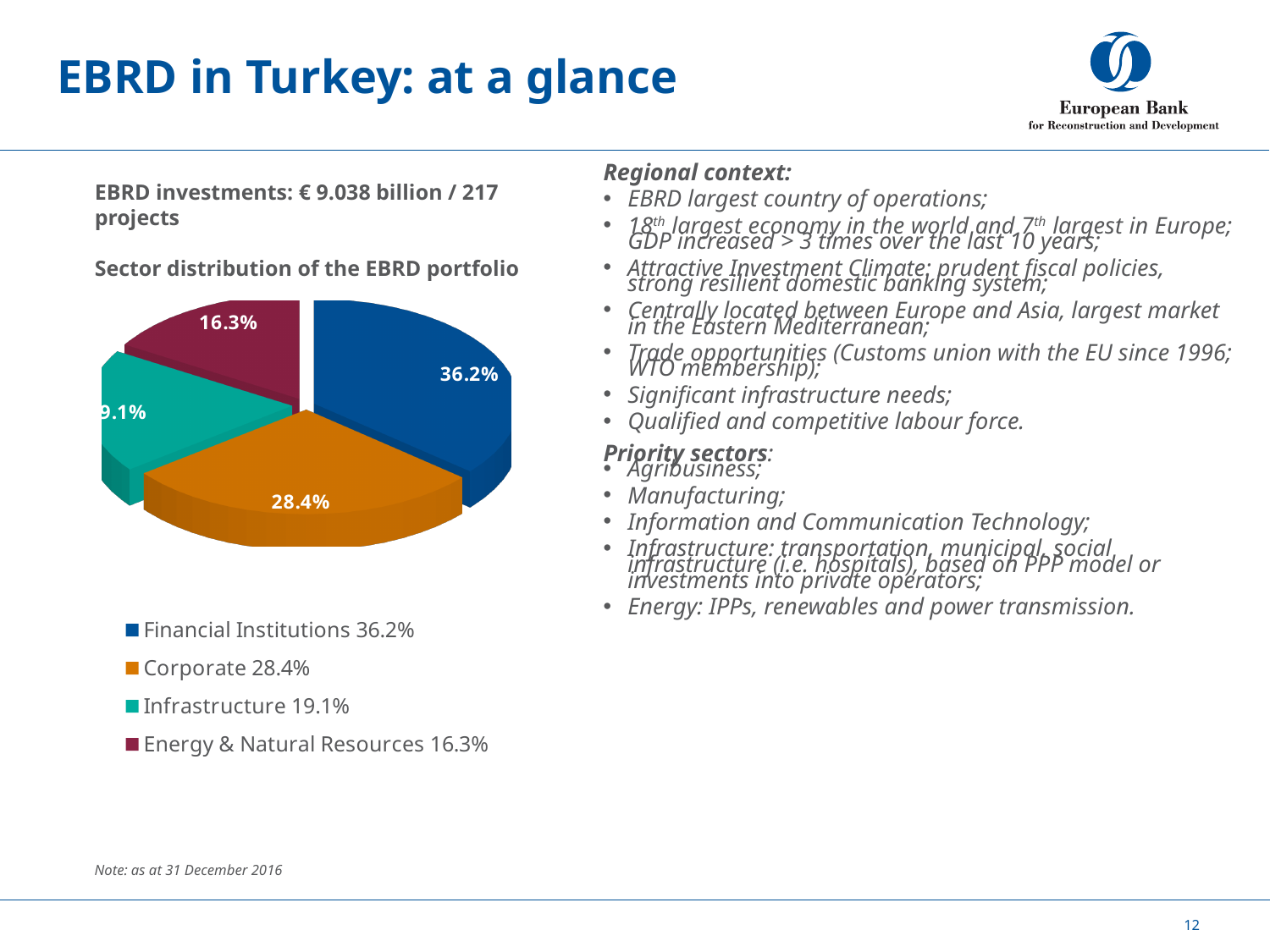
Which sector has the largest share of the EBRD portfolio? Financial Institutions Which is larger, the Infrastructure share or the Energy & Natural Resources share? Infrastructure What share of the EBRD portfolio is Energy & Natural Resources? 16.3% What share of the EBRD portfolio is Corporate? 28.4% How many sectors are shown in the pie chart? 4 What is the difference in percentage points between the Financial Institutions and Corporate shares? 7.8 Which sector has the smallest share of the EBRD portfolio? Energy & Natural Resources What share of the EBRD portfolio is Financial Institutions? 36.2% What kind of chart is shown on the slide? Pie chart What colour is the Corporate slice in the pie chart? Orange What share of the EBRD portfolio is Infrastructure? 19.1% What is the title of the pie chart? Sector distribution of the EBRD portfolio